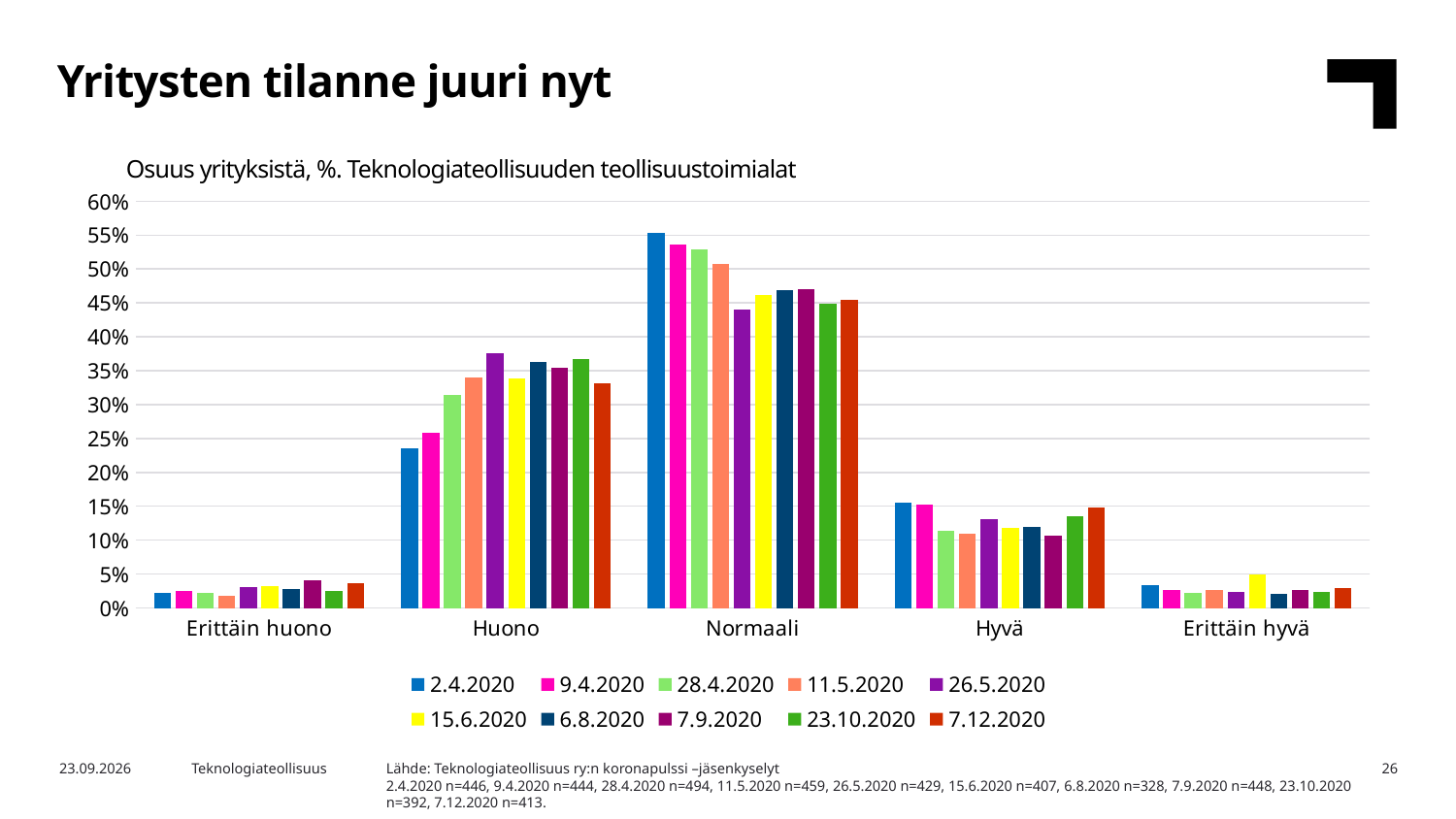
What is the title of the slide? Yritysten tilanne juuri nyt What kind of chart is shown on the slide? bar chart Which is larger for 2.4.2020: the value for Hyvä or the value for Erittäin hyvä? Hyvä Which category has the highest values overall? Normaali Is the value for 2.4.2020 in the Normaali category greater or less than 50%? greater How many categories are shown on the x axis? 5 Within the Huono category, which survey date has the lowest bar? 2.4.2020 Is the value for 7.12.2020 in the Huono category greater or less than 30%? greater Within the Normaali category, which survey date has the highest bar? 2.4.2020 In the Huono category, which is larger: the value for 26.5.2020 or the value for 2.4.2020? 26.5.2020 How many series does the legend list? 10 Is the value for 2.4.2020 in the Huono category greater or less than 25%? less